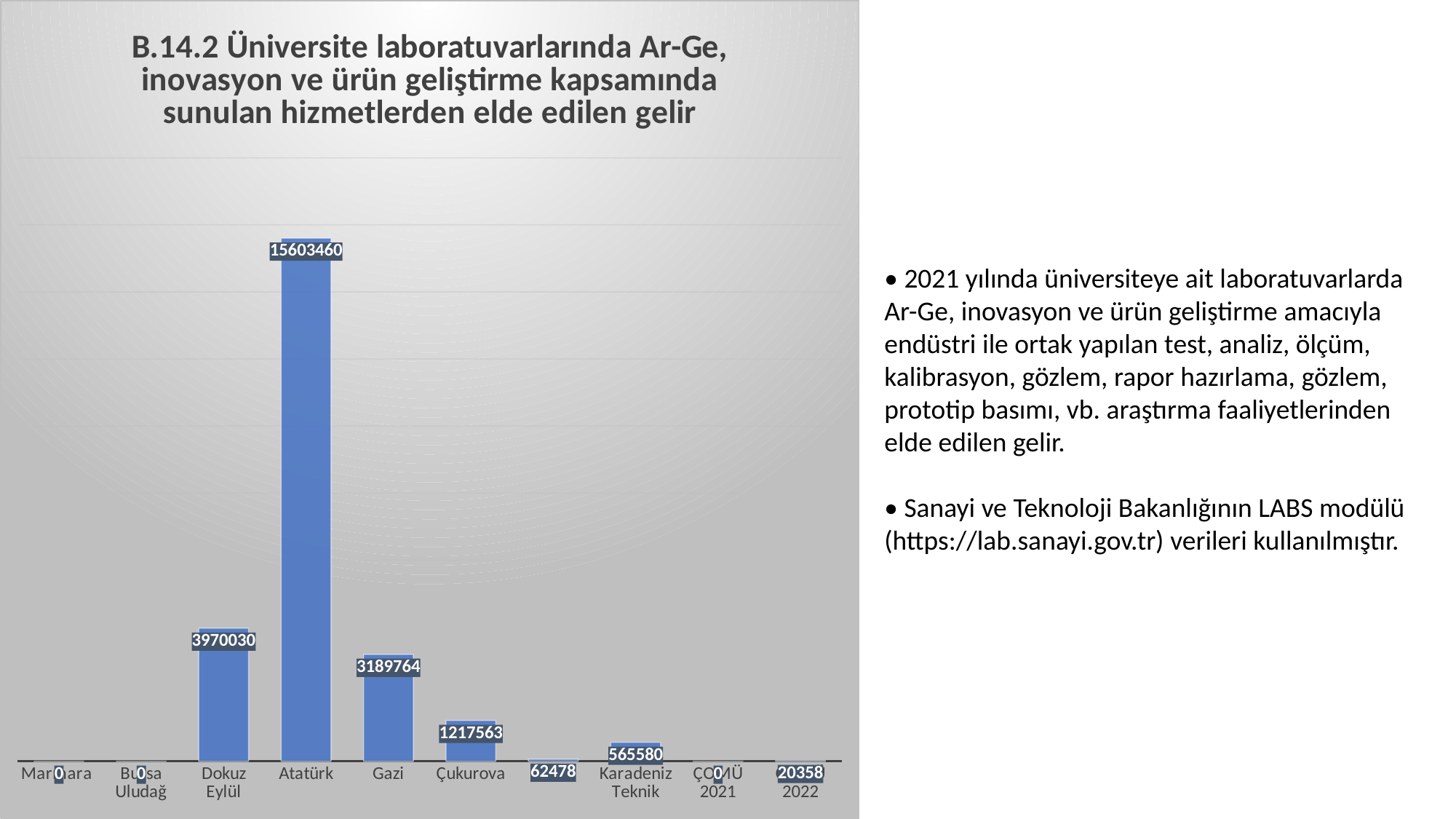
Which is larger, the value for Gazi or the value for Çukurova? Gazi What is the value for Marmara? 0 What is the value for Atatürk? 15603460 What is the value for Gazi? 3189764 What kind of chart is shown on the slide? Bar chart Which category has the highest value? Atatürk What is the value for Karadeniz Teknik? 565580 What is the difference between the values for Dokuz Eylül and Gazi? 780266 How many bars are shown in the chart? 10 What is the value for Dokuz Eylül? 3970030 What is the value for Çukurova? 1217563 What is the difference between the values for Atatürk and Dokuz Eylül? 11633430